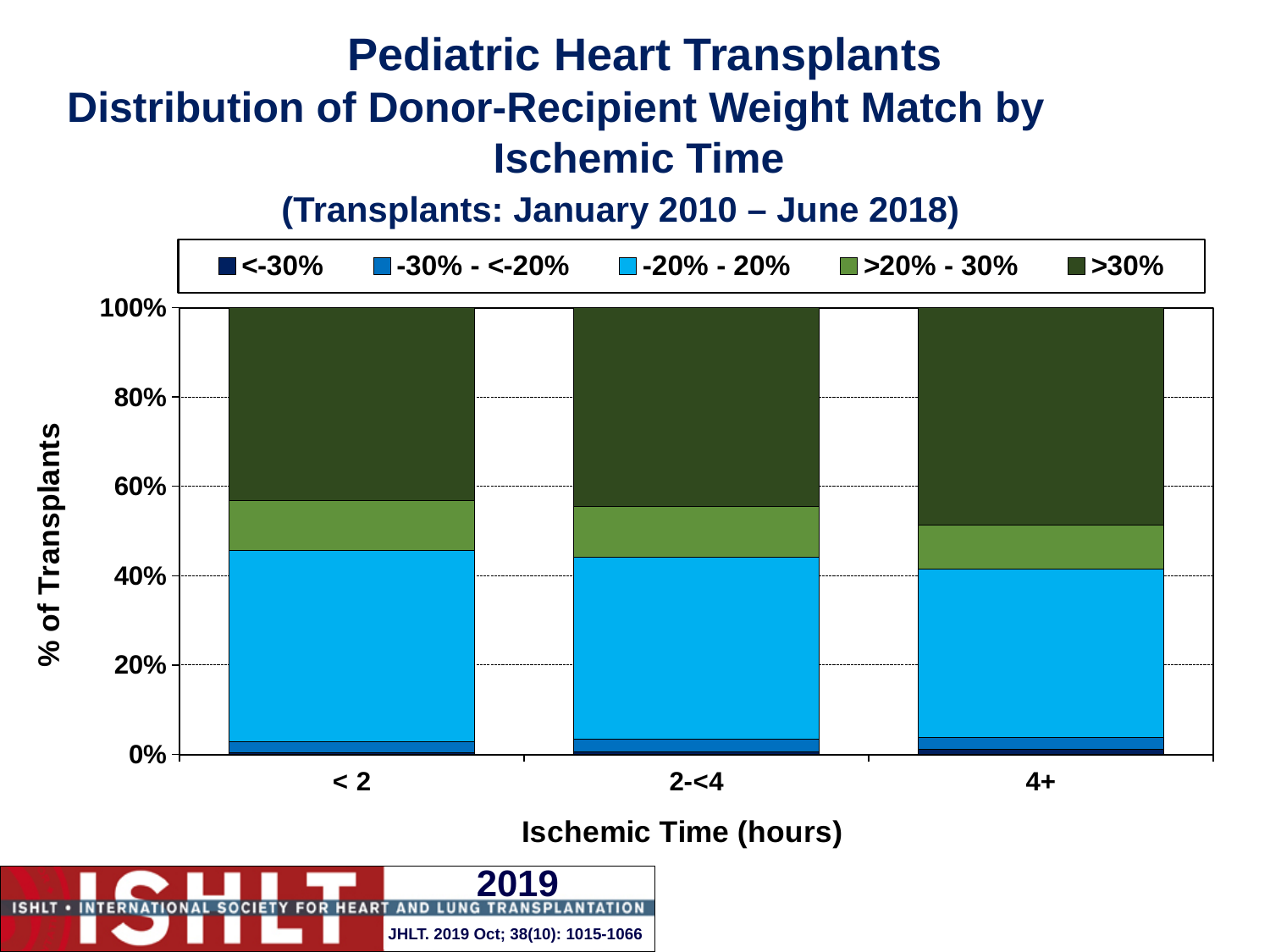
Is the cumulative top of the -30% - <-20% segment for the 2-<4 hours bar greater or less than 20%? less Which ischemic time category has the largest >30% segment? 4+ Is the cumulative top of the -20% - 20% segment for the < 2 hours bar greater or less than 40%? greater What is the total height of the stacked bar for the < 2 hours category? 100% How many ischemic time categories are shown on the x axis? 3 How many series does the legend list? 5 Is the >30% segment larger for the 4+ hours bar or the < 2 hours bar? 4+ What is the label of the x axis? Ischemic Time (hours) Is the cumulative top of the >20% - 30% segment for the 4+ hours bar greater or less than 60%? less What is the label of the y axis? % of Transplants Does the share of the >30% segment rise or fall as ischemic time increases along the x axis? rise What kind of chart is shown on the slide? Stacked bar chart